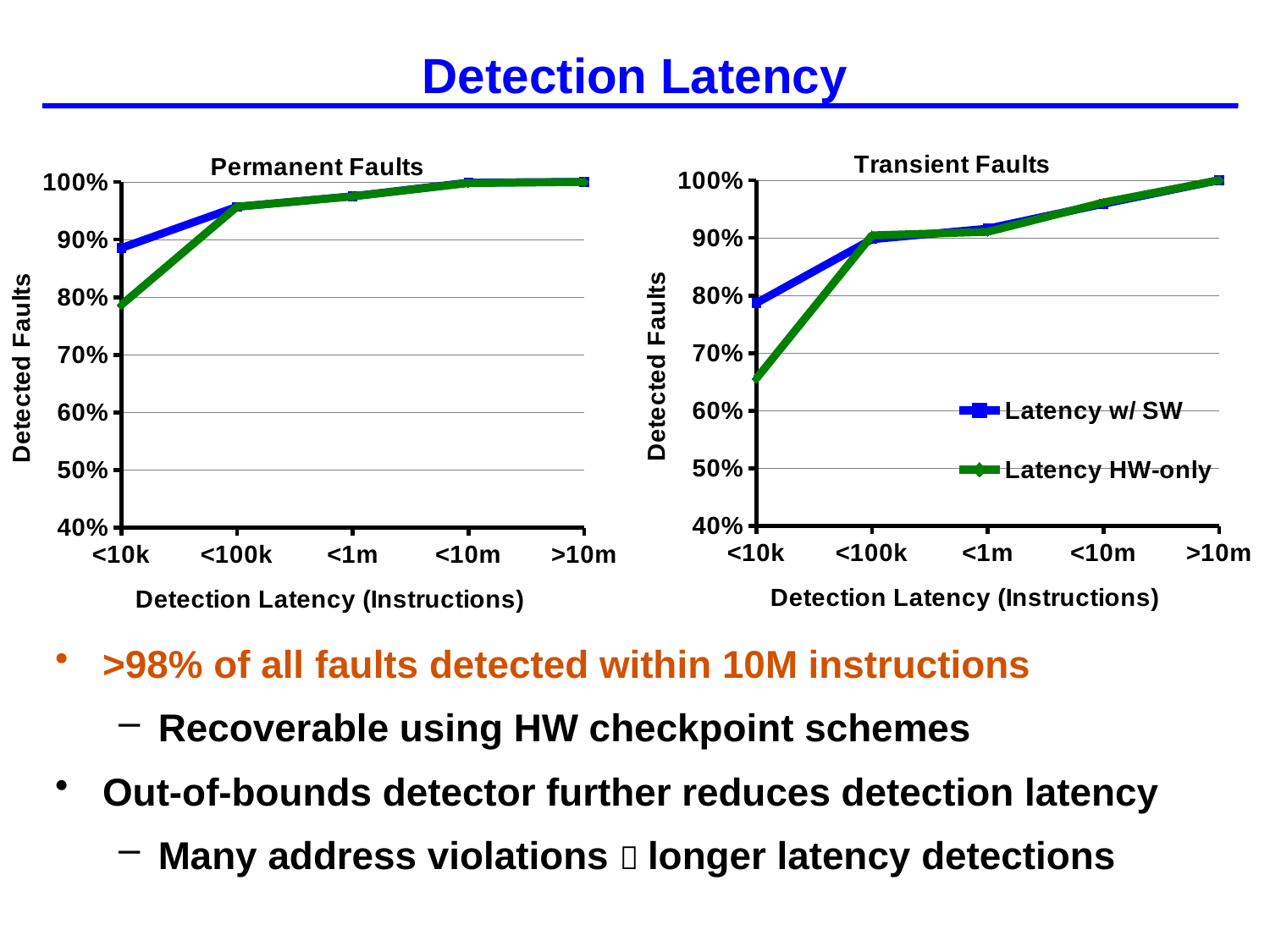
In the Transient Faults chart, is the value for Latency w/ SW at <10k greater or less than 80%? less In the Transient Faults chart, which series has the larger value at <10k, Latency w/ SW or Latency HW-only? Latency w/ SW What is the x-axis title of the Permanent Faults chart? Detection Latency (Instructions) In the Transient Faults chart, is the value for Latency HW-only at <10k greater or less than 70%? less In the Transient Faults chart, at which detection latency category is the Latency HW-only value lowest? <10k What kind of chart is the Permanent Faults chart? line chart In the Permanent Faults chart, which series has the larger value at <10k, Latency w/ SW or Latency HW-only? Latency w/ SW In the Permanent Faults chart, is the value for Latency w/ SW at <10k greater or less than 90%? less How many series does the legend on the Transient Faults chart list? 2 How many detection latency categories are shown on the x axis of the Transient Faults chart? 5 In the Permanent Faults chart, do the values for Latency HW-only rise or fall along the x axis? rise